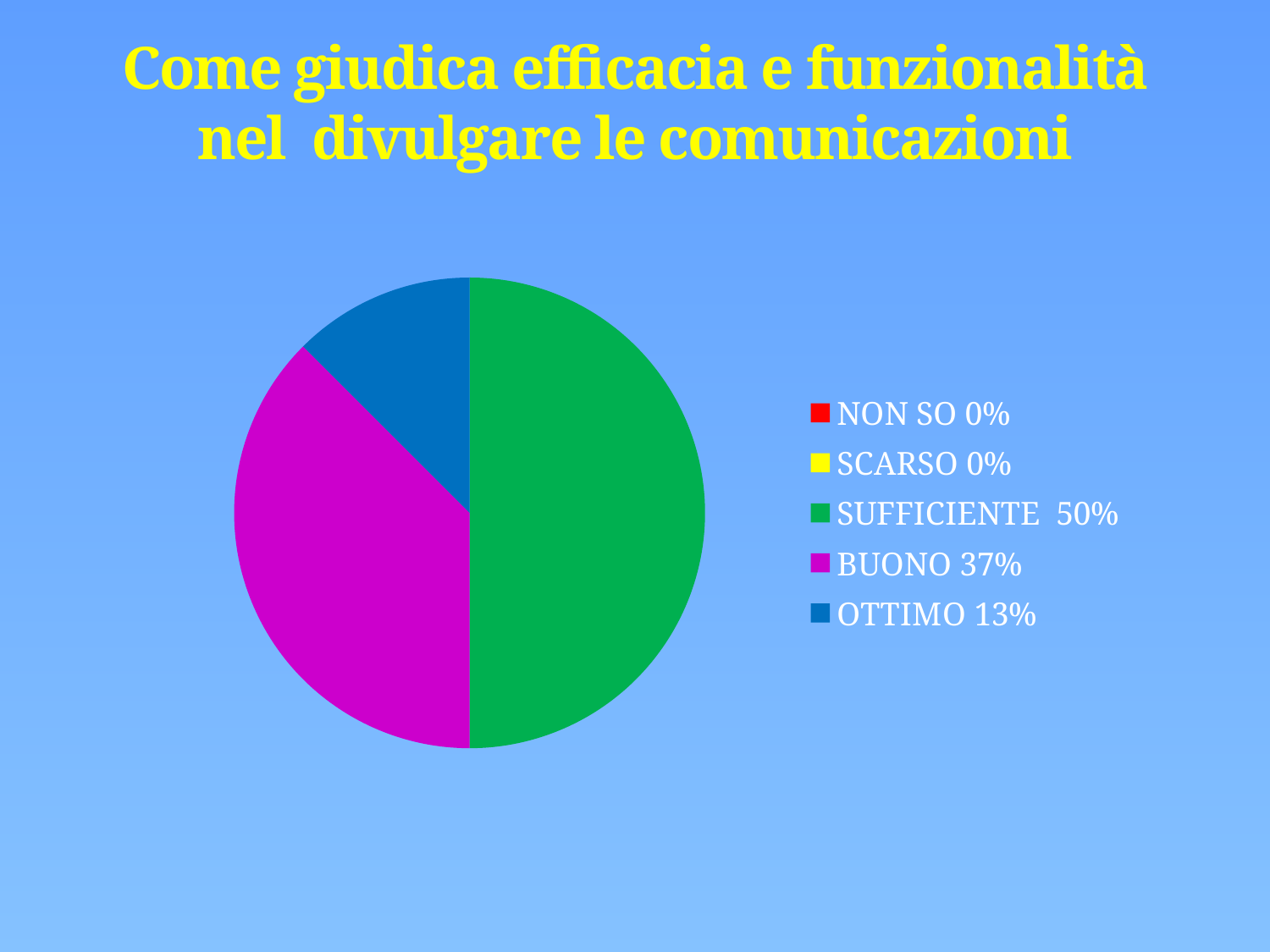
What is the value shown for SCARSO? 0% Which category has the largest share of the pie? SUFFICIENTE What share of the pie does BUONO have? 37% How many categories does the legend list? 5 What colour is the slice for BUONO? magenta What share of the pie does SUFFICIENTE have? 50% Which category has the smallest non-zero share of the pie? OTTIMO What kind of chart is shown on the slide? pie chart What is the difference between the shares of SUFFICIENTE and BUONO? 13% What is the value shown for NON SO? 0% Which is larger, the share for BUONO or the share for OTTIMO? BUONO What share of the pie does OTTIMO have? 13%